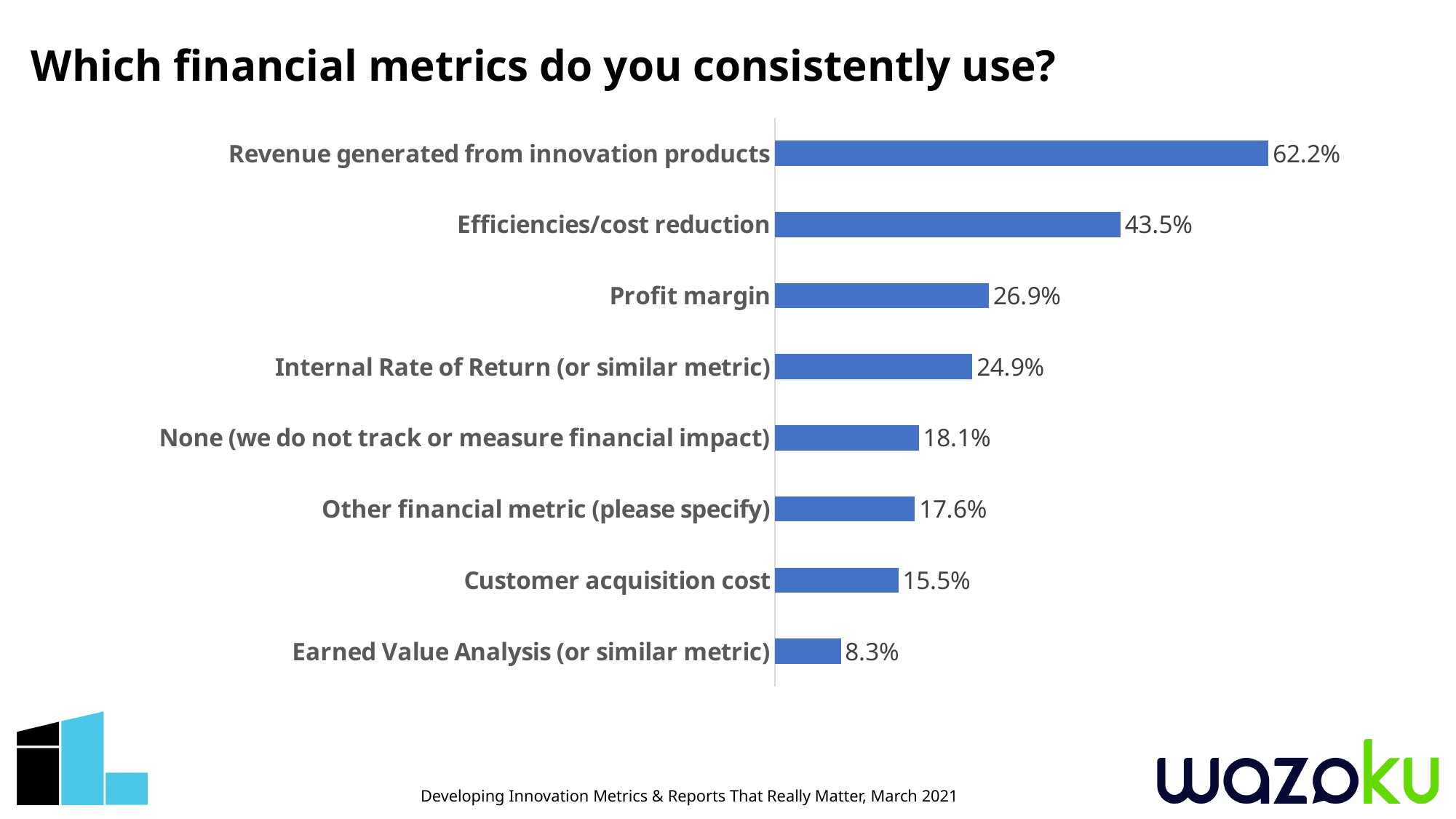
What is the difference in percentage points between Profit margin and Internal Rate of Return (or similar metric)? 2.0 How many financial metric categories are shown in the chart? 8 What is the title of the chart? Which financial metrics do you consistently use? What percentage of respondents consistently use revenue generated from innovation products? 62.2% Which financial metric has the highest percentage? Revenue generated from innovation products Which is larger: the value for Efficiencies/cost reduction or the value for Profit margin? Efficiencies/cost reduction What is the value for Profit margin? 26.9% What is the difference in percentage points between Revenue generated from innovation products and Efficiencies/cost reduction? 18.7 What percentage selected 'None (we do not track or measure financial impact)'? 18.1% Which financial metric has the lowest percentage? Earned Value Analysis (or similar metric) What is the value for Customer acquisition cost? 15.5% What type of chart is shown on the slide? Bar chart